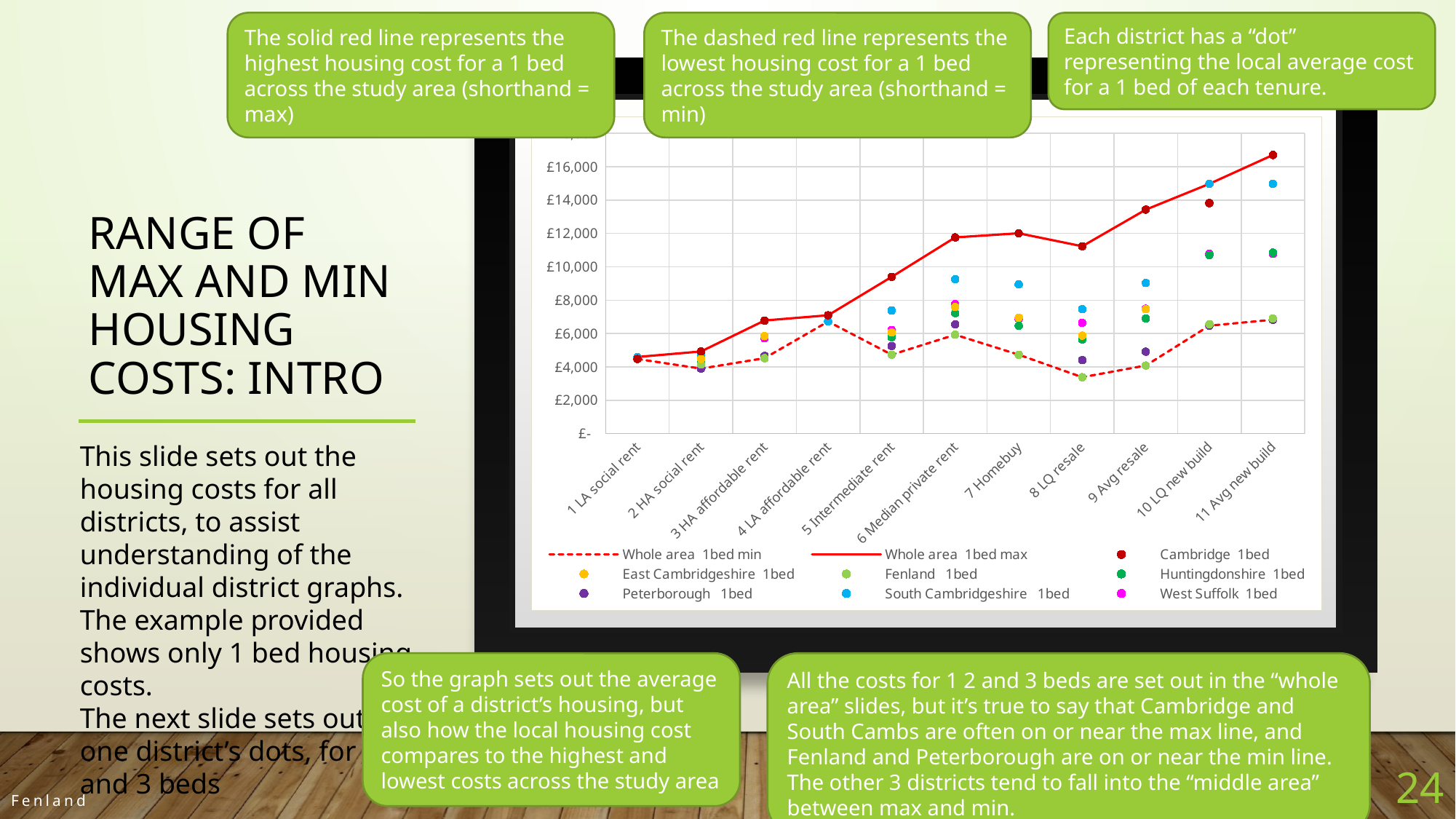
Is the Whole area 1bed min value for 8 LQ resale greater or less than £4,000? less What kind of chart is shown on the slide? line chart For 10 LQ new build, which is larger: the South Cambridgeshire 1bed value or the Cambridge 1bed value? South Cambridgeshire 1bed For which category does the Whole area 1bed min line reach its lowest value? 8 LQ resale Is the South Cambridgeshire 1bed value for 10 LQ new build greater or less than £14,000? greater Does the Whole area 1bed max line generally rise or fall from 1 LA social rent to 11 Avg new build? rise How many series does the chart's legend list? 9 For which category does the Whole area 1bed max line reach its highest value? 11 Avg new build Is the Cambridge 1bed value for 9 Avg resale greater or less than £12,000? greater How many categories are shown along the x axis of the chart? 11